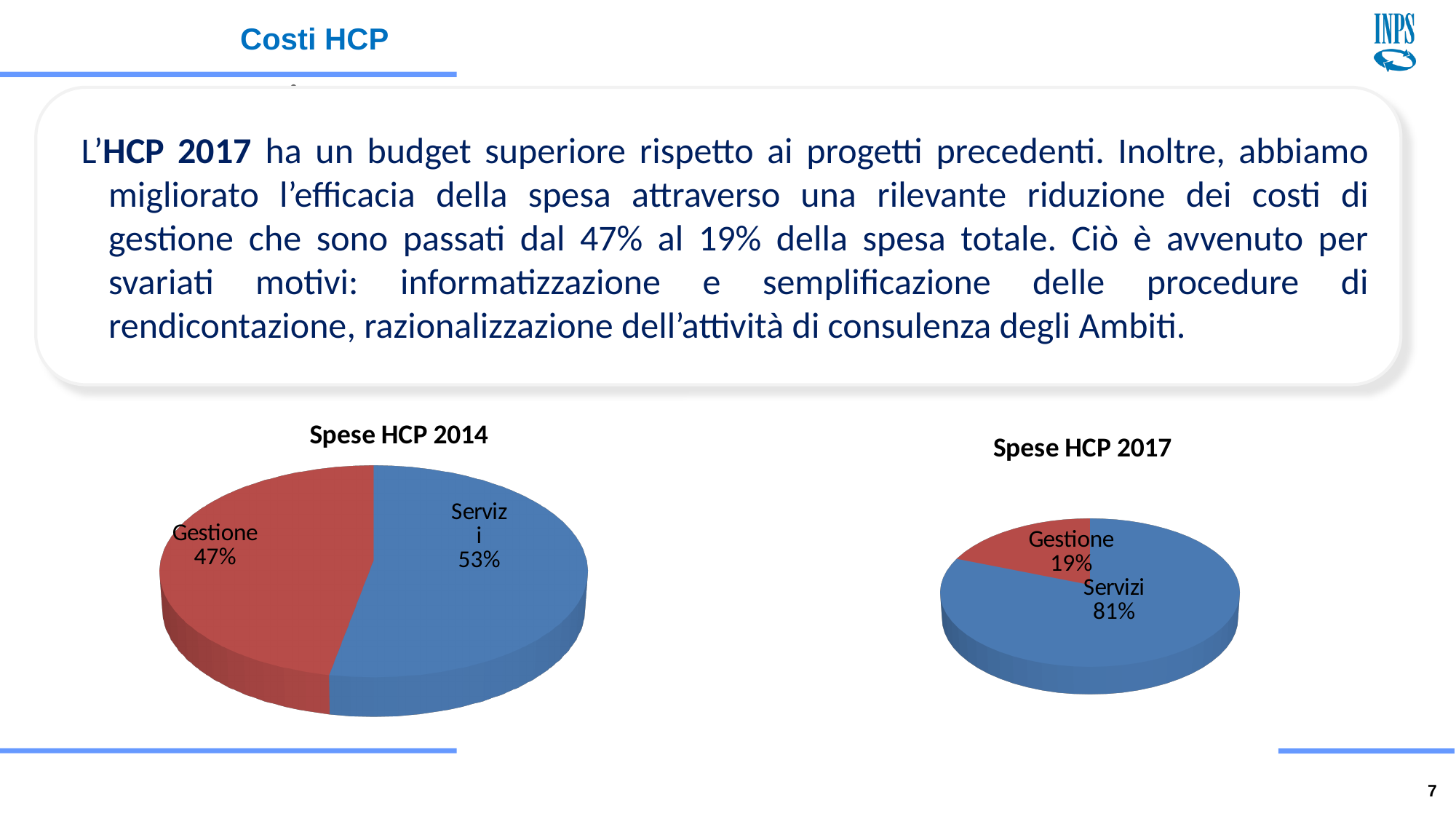
In the 'Spese HCP 2017' chart, what share of spending is Servizi? 81% In the 'Spese HCP 2014' chart, what colour is the Gestione slice? Red In the 'Spese HCP 2014' chart, what share of spending is Servizi? 53% In the 'Spese HCP 2014' chart, which is larger, Gestione or Servizi? Servizi What is the title of the chart on the right side of the slide? Spese HCP 2017 In the 'Spese HCP 2017' chart, what is the difference between the Servizi and Gestione shares? 62% In the 'Spese HCP 2017' chart, which slice is the largest? Servizi In the 'Spese HCP 2017' chart, which slice is the smallest? Gestione In the 'Spese HCP 2017' chart, what share of spending is Gestione? 19% In the 'Spese HCP 2014' chart, what share of spending is Gestione? 47% How many slices does the 'Spese HCP 2017' chart have? 2 What type of chart is 'Spese HCP 2014'? Pie chart